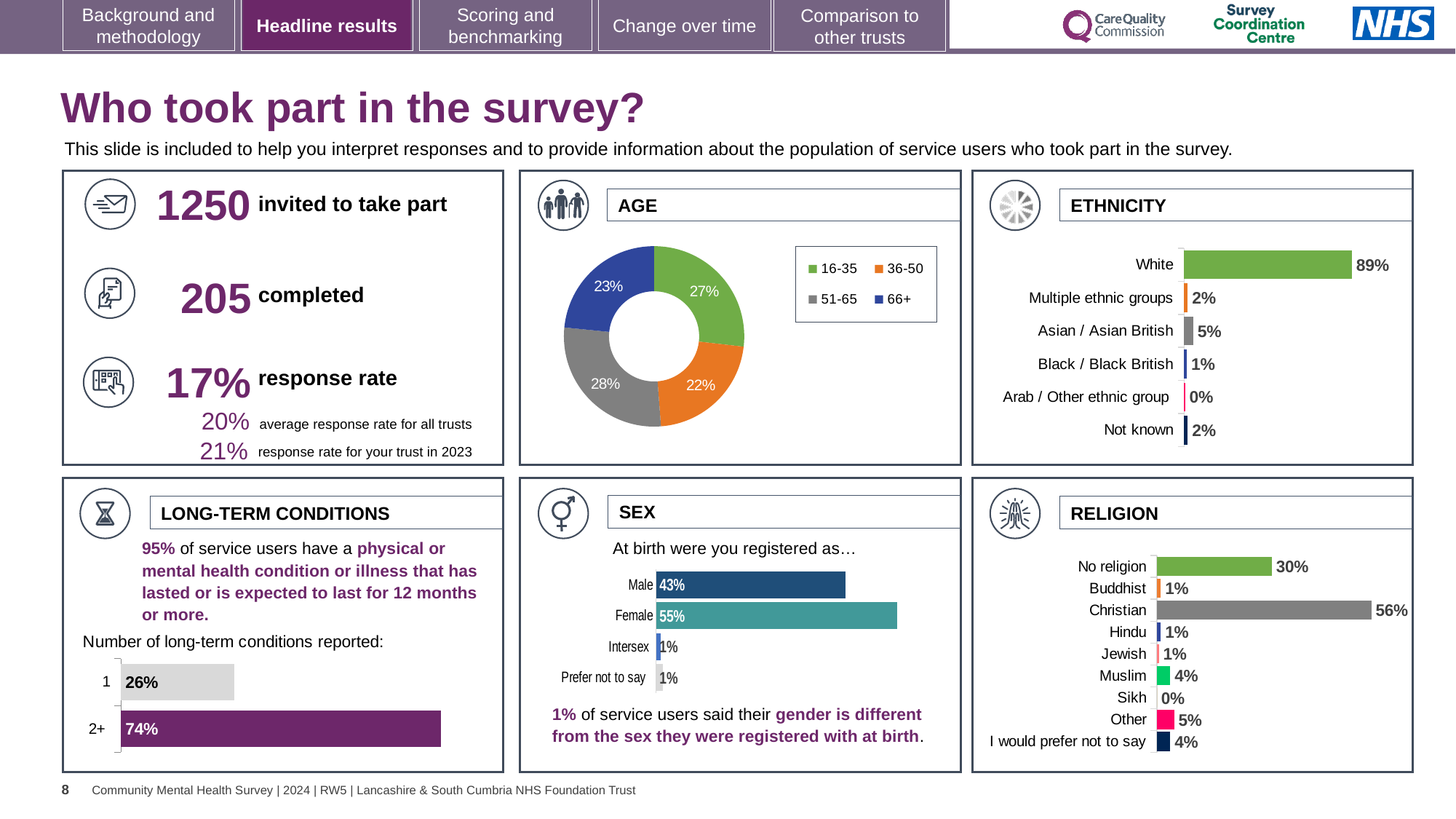
In the RELIGION chart, what is the value for Muslim? 4% In the AGE chart, which age group has the smallest share? 36-50 In the AGE chart, what percentage of respondents were aged 51-65? 28% How many categories are shown in the ETHNICITY chart? 6 How many entries does the legend of the AGE chart list? 4 In the LONG-TERM CONDITIONS chart, what percentage reported 2+ conditions? 74% In the ETHNICITY chart, which category has the highest value? White In the SEX chart, which is larger, Male or Female? Female In the ETHNICITY chart, what is the value for Asian / Asian British? 5% What kind of chart is the AGE chart? Donut (pie) chart In the ETHNICITY chart, what is the difference between White and Asian / Asian British? 84% How many categories are shown in the RELIGION chart? 9